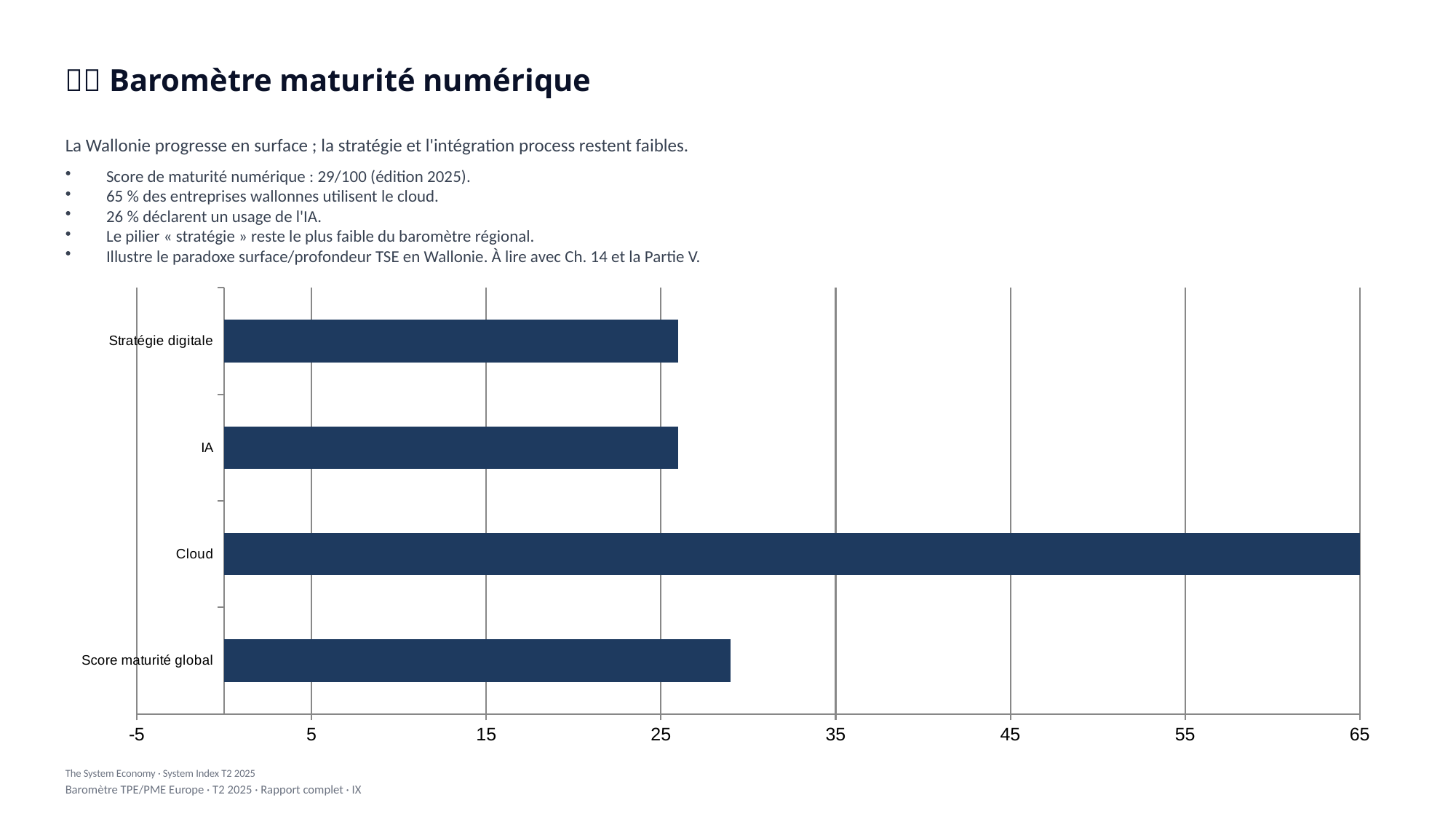
Is the value for Score maturité global greater or less than 25? greater What colour are the bars in the chart? dark navy blue How many categories are plotted in the chart? 4 Which is larger, the value for Cloud or the value for IA? Cloud Is the value for Score maturité global greater or less than 35? less Which category has the highest value in the chart? Cloud What is the highest tick value shown on the horizontal axis of the chart? 65 What kind of chart is shown on the slide? bar chart What is the value for Cloud in the chart? 65 Is the value for Stratégie digitale greater or less than 35? less Which is larger, the value for Score maturité global or the value for Stratégie digitale? Score maturité global